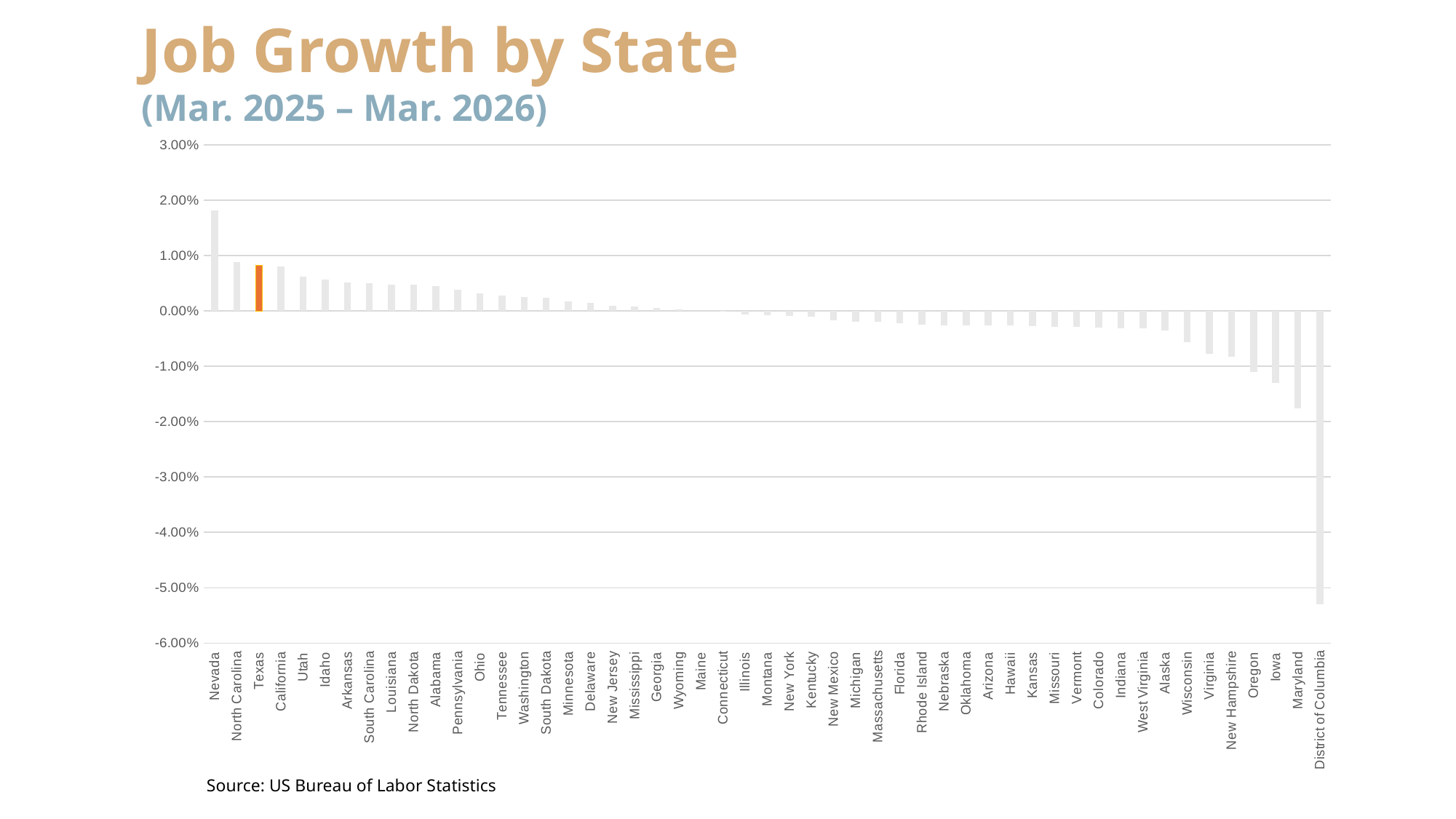
Is the value for Texas greater or less than 1.00%? less Is the value for Maryland greater or less than -1.00%? less Which has the larger value, Nevada or North Carolina? Nevada Which has the larger value, Oregon or Iowa? Oregon How many categories are plotted in the chart? 51 Which state has the highest job growth in the chart? Nevada Which state's bar is highlighted in orange? Texas Which category has the lowest value in the chart? District of Columbia Is the value for Nevada greater or less than 1.00%? greater What kind of chart is shown on the slide? bar chart Do the values rise or fall moving from left to right along the x axis? fall